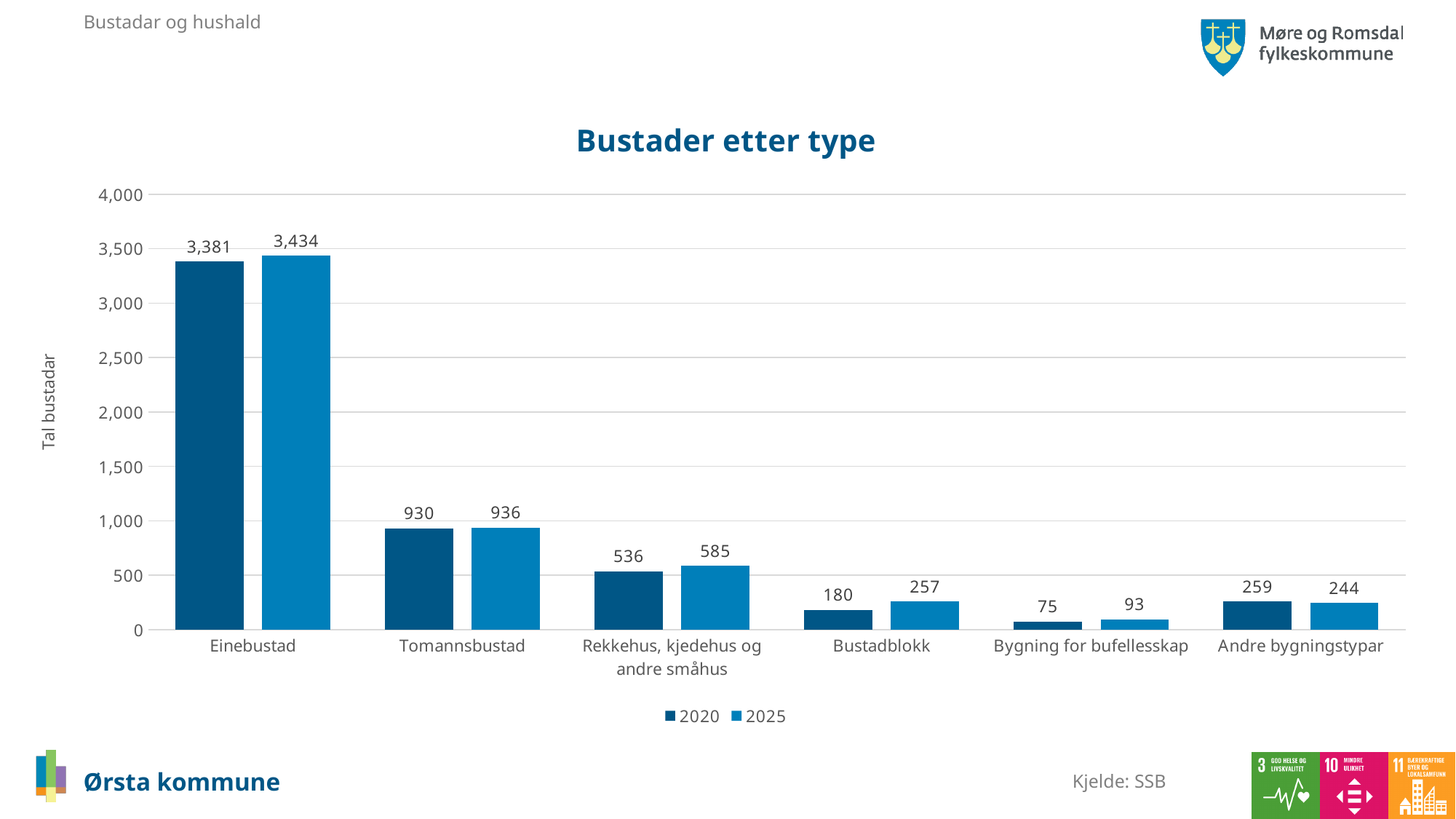
Which category has the highest value in 2020? Einebustad What is the value for Bygning for bufellesskap in 2025? 93 What is the difference between the 2020 and 2025 values for Einebustad? 53 Is the 2025 value for Rekkehus, kjedehus og andre småhus greater or less than 500? greater Which category has the lowest value in 2025? Bygning for bufellesskap What is the value for Einebustad in 2025? 3,434 Which is larger for Andre bygningstypar: the 2020 value or the 2025 value? 2020 How many series does the legend list? 2 What is the value for Bustadblokk in 2020? 180 What type of chart is shown? Bar chart How many categories are shown on the x axis? 6 What is the difference between the 2025 and 2020 values for Bustadblokk? 77